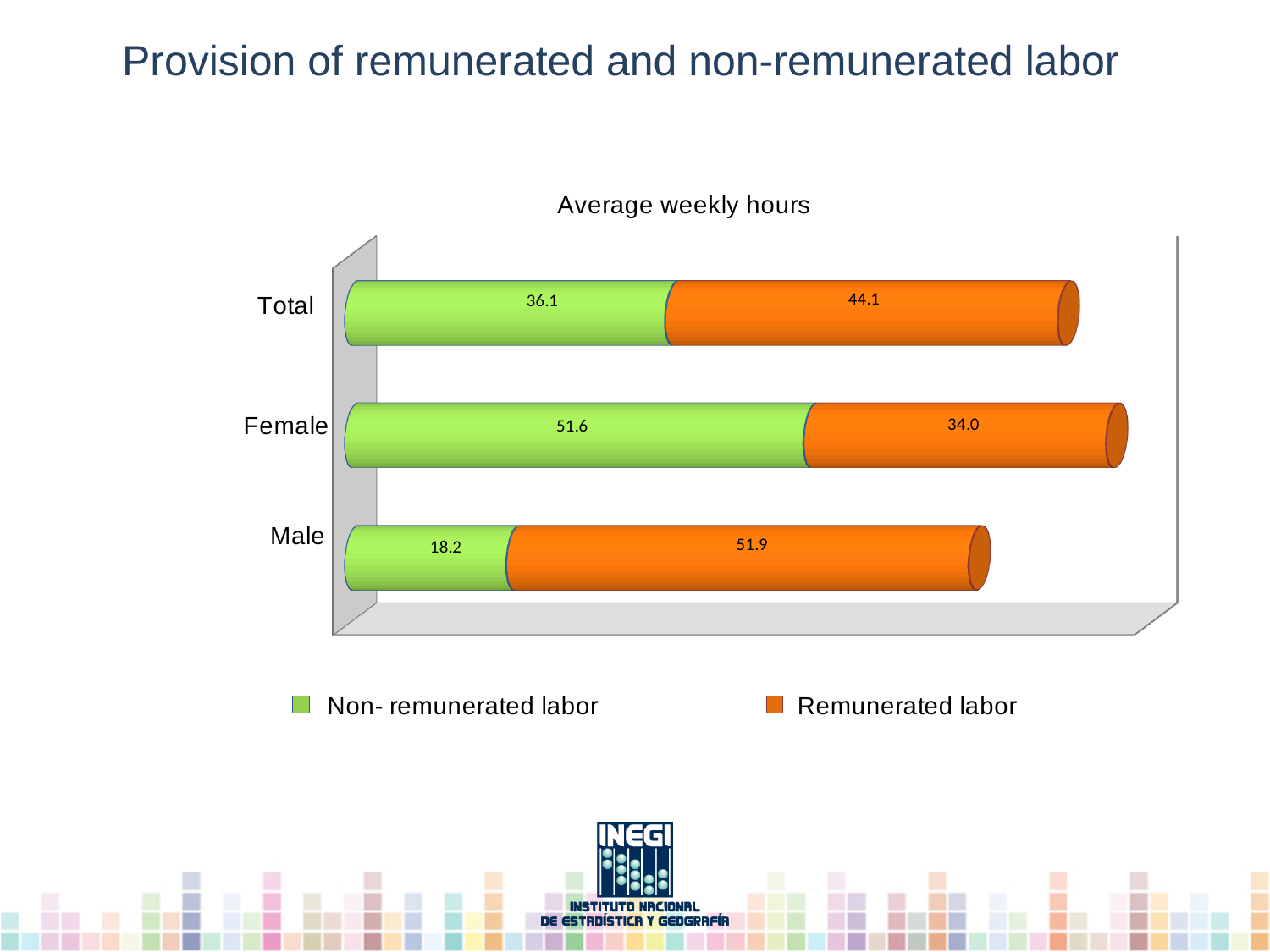
What is the value for Non- remunerated labor for Total? 36.1 What is the value for Non- remunerated labor for Female? 51.6 What is the value for Remunerated labor for Male? 51.9 What is the total of the stacked bar for Male? 70.1 How many categories are shown on the chart? 3 Which is larger for Male: Non- remunerated labor or Remunerated labor? Remunerated labor Which category has the highest value for Non- remunerated labor? Female What kind of chart is shown on the slide? Stacked bar chart What is the difference between the Remunerated labor values for Male and Female? 17.9 How many series does the legend list? 2 What is the title shown above the chart? Average weekly hours Which category has the lowest value for Remunerated labor? Female